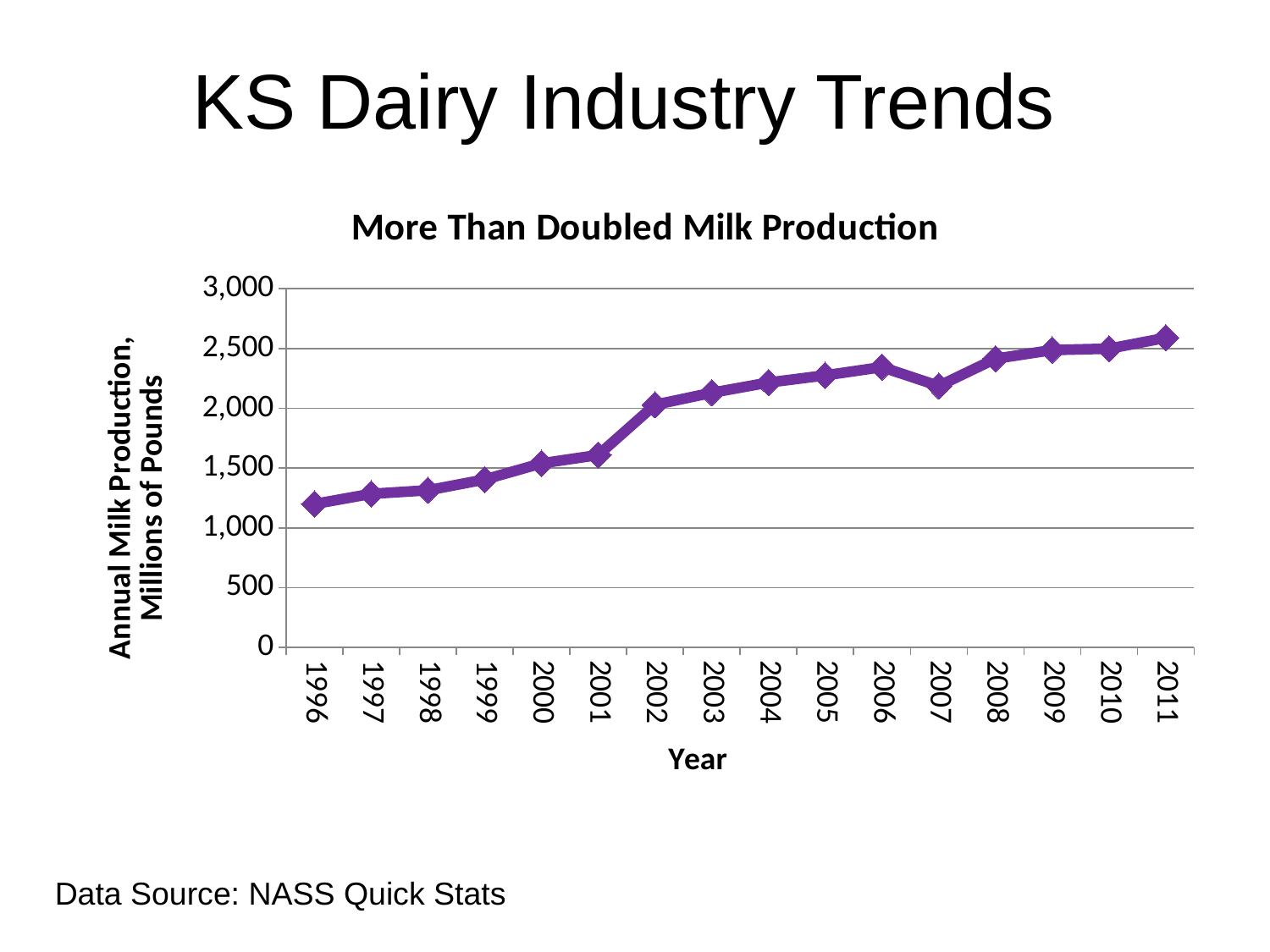
Is the value for 2007 greater or less than 2,500? less Which year has the larger milk production, 2001 or 2002? 2002 How many years are plotted on the x axis of the chart? 16 Is the value for 1996 greater or less than 1,500? less Which year has the highest annual milk production in the chart? 2011 Is the value for 2011 greater or less than 2,500? greater Overall, do the values rise or fall from 1996 to 2011? rise Which year has the lowest annual milk production in the chart? 1996 What kind of chart is shown on the slide? line chart What is the title of the chart? More Than Doubled Milk Production Which year has the larger milk production, 2006 or 2007? 2006